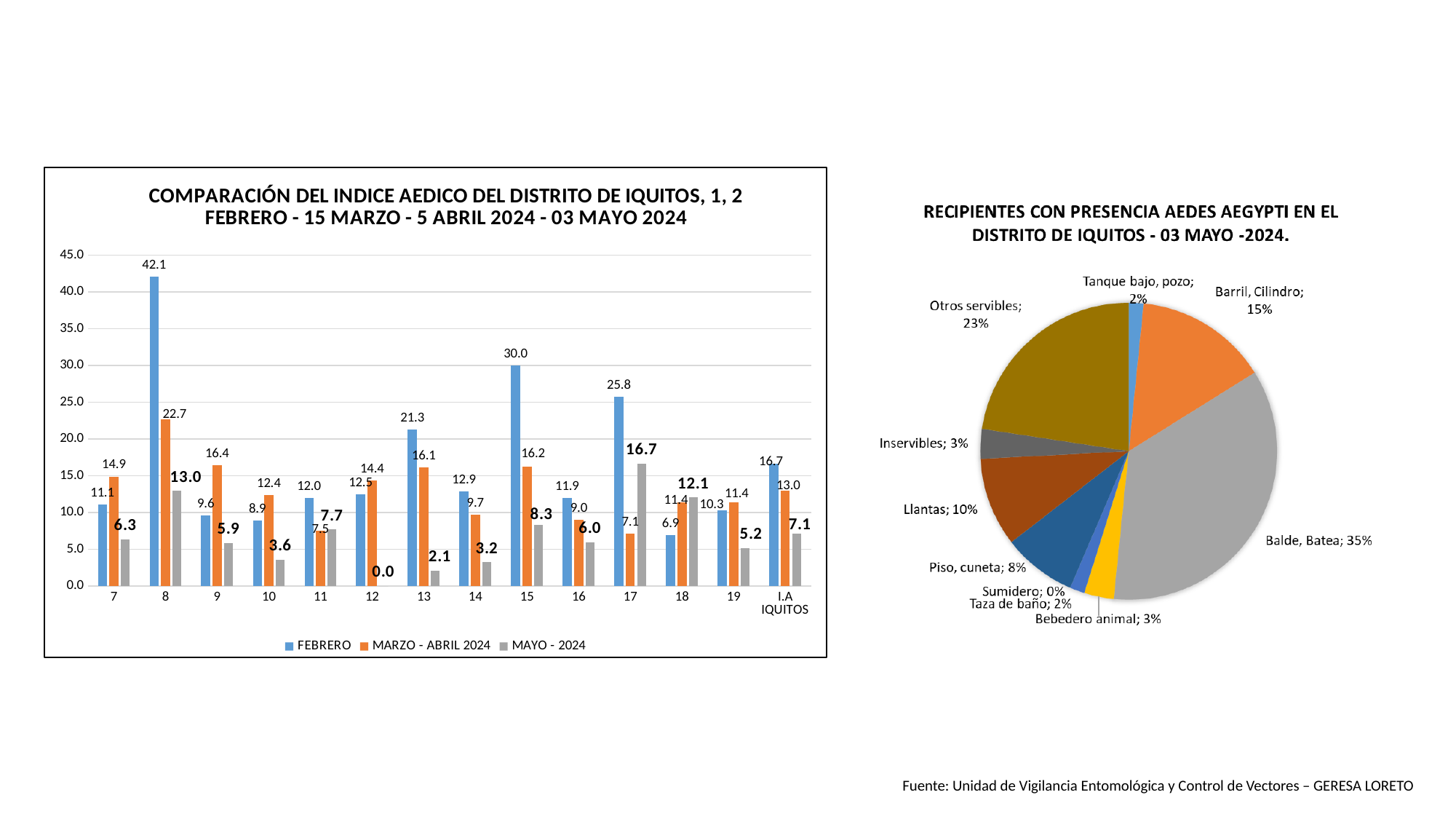
In the bar chart on the left, what is the MARZO - ABRIL 2024 value for I.A IQUITOS? 13.0 In the bar chart on the left, which category has the highest FEBRERO value? 8 In the bar chart on the left, how many series does the legend list? 3 In the bar chart on the left, what is the difference between the FEBRERO and MARZO - ABRIL 2024 values for category 15? 13.8 In the bar chart on the left, which category has the lowest MAYO - 2024 value? 12 In the bar chart on the left, what is the MAYO - 2024 value for category 17? 16.7 In the pie chart on the right, which slice is the largest? Balde, Batea In the pie chart on the right, what share does Balde, Batea have? 35% What kind of chart is shown on the right side of the slide? Pie chart In the bar chart on the left, how many categories are shown on the x axis? 14 In the bar chart on the left, which is larger for category 18: the FEBRERO value or the MAYO - 2024 value? MAYO - 2024 In the bar chart on the left, what is the FEBRERO value for category 8? 42.1